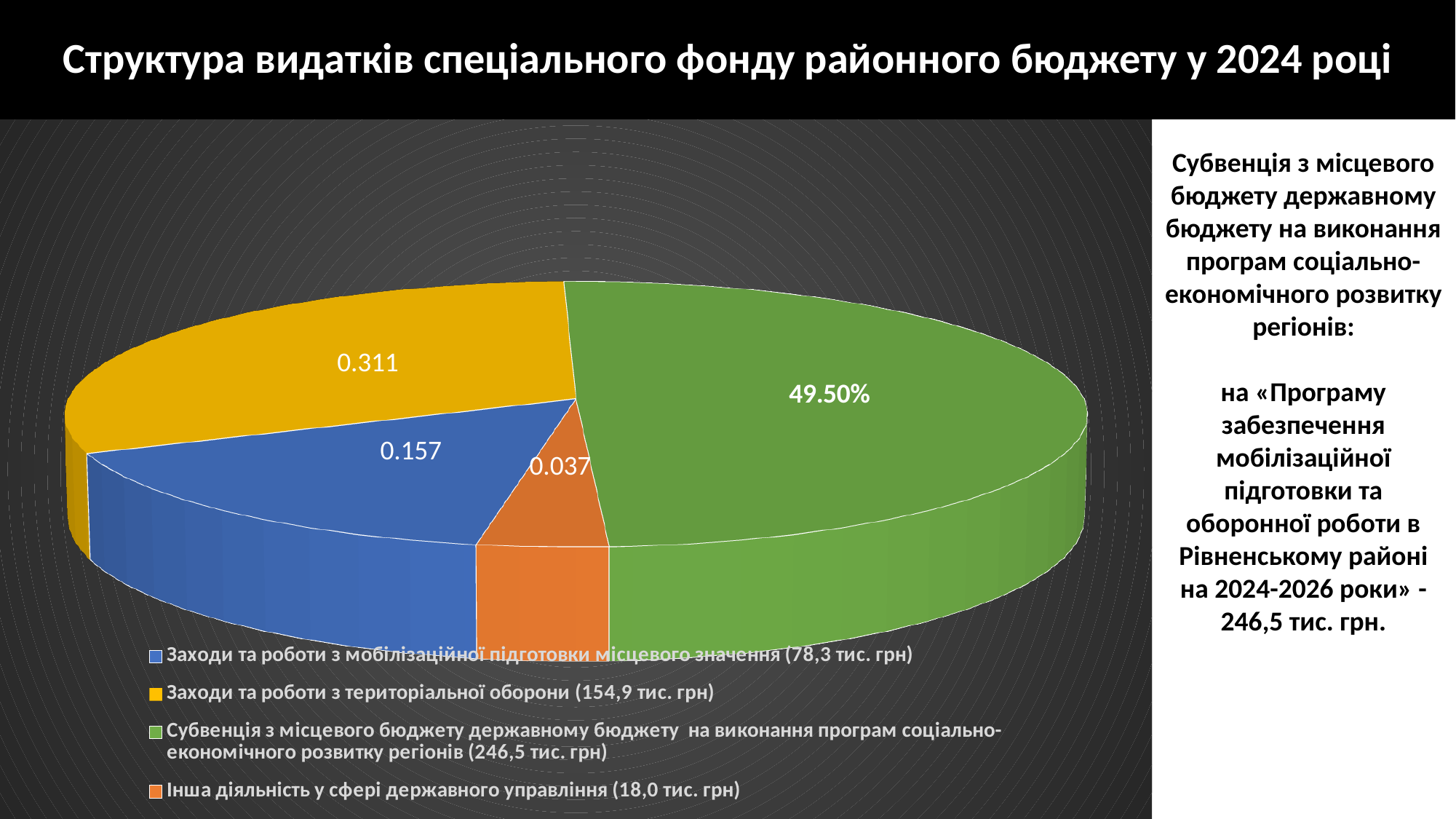
What is the difference between the printed values of the yellow slice (0.311) and the blue slice (0.157)? 0.154 Which category has the smallest slice of the pie? Інша діяльність у сфері державного управління What amount does the legend give for Заходи та роботи з територіальної оборони? 154,9 тис. грн What value is printed on the orange slice (Інша діяльність у сфері державного управління)? 0.037 How many slices does the pie chart have? 4 What kind of chart is shown on the slide? Pie chart Which slice is larger: Заходи та роботи з територіальної оборони or Заходи та роботи з мобілізаційної підготовки місцевого значення? Заходи та роботи з територіальної оборони What value is printed on the yellow slice (Заходи та роботи з територіальної оборони)? 0.311 What value is printed on the blue slice (Заходи та роботи з мобілізаційної підготовки місцевого значення)? 0.157 What value is printed on the green slice (Субвенція з місцевого бюджету державному бюджету на виконання програм соціально-економічного розвитку регіонів)? 49.50% Which category has the largest slice of the pie? Субвенція з місцевого бюджету державному бюджету на виконання програм соціально-економічного розвитку регіонів What is the title of the slide's chart? Структура видатків спеціального фонду районного бюджету у 2024 році